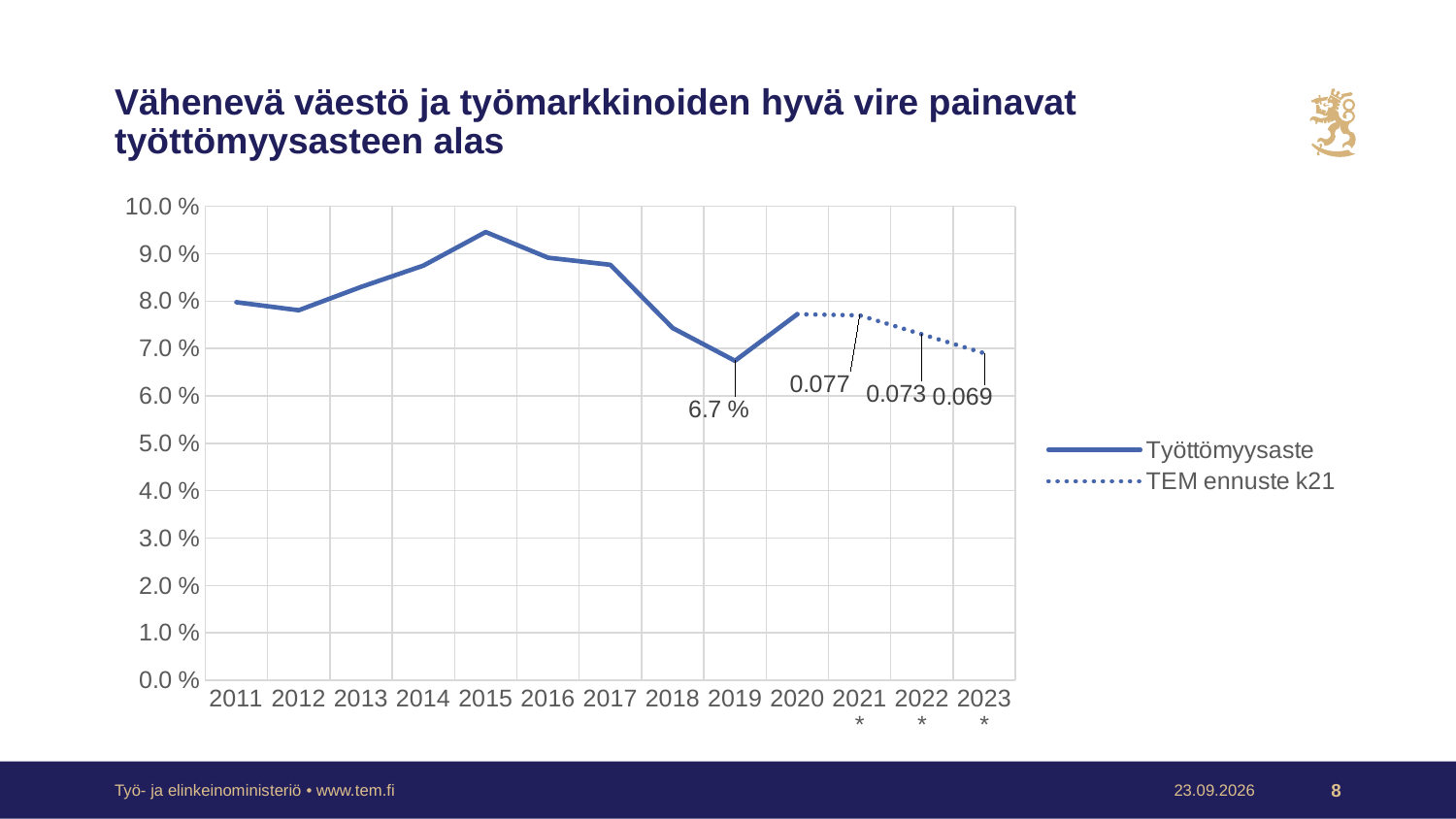
What value is labelled for 2023* on the TEM ennuste k21 series? 0.069 What value is labelled for 2021* on the TEM ennuste k21 series? 0.077 What is the difference between the labelled forecast values for 2021* and 2023*? 0.008 Is the Työttömyysaste value for 2015 greater or less than 9.0 %? greater How many series does the chart legend list? 2 In which year does the Työttömyysaste line reach its lowest value? 2019 How many years are shown on the x axis of the chart? 13 Is the Työttömyysaste value for 2018 greater or less than 8.0 %? less What kind of chart is shown on the slide? Line chart Which year has the higher Työttömyysaste value, 2013 or 2018? 2013 In which year does the Työttömyysaste line reach its highest value? 2015 What is the data label shown for 2019 on the Työttömyysaste line? 6.7 %